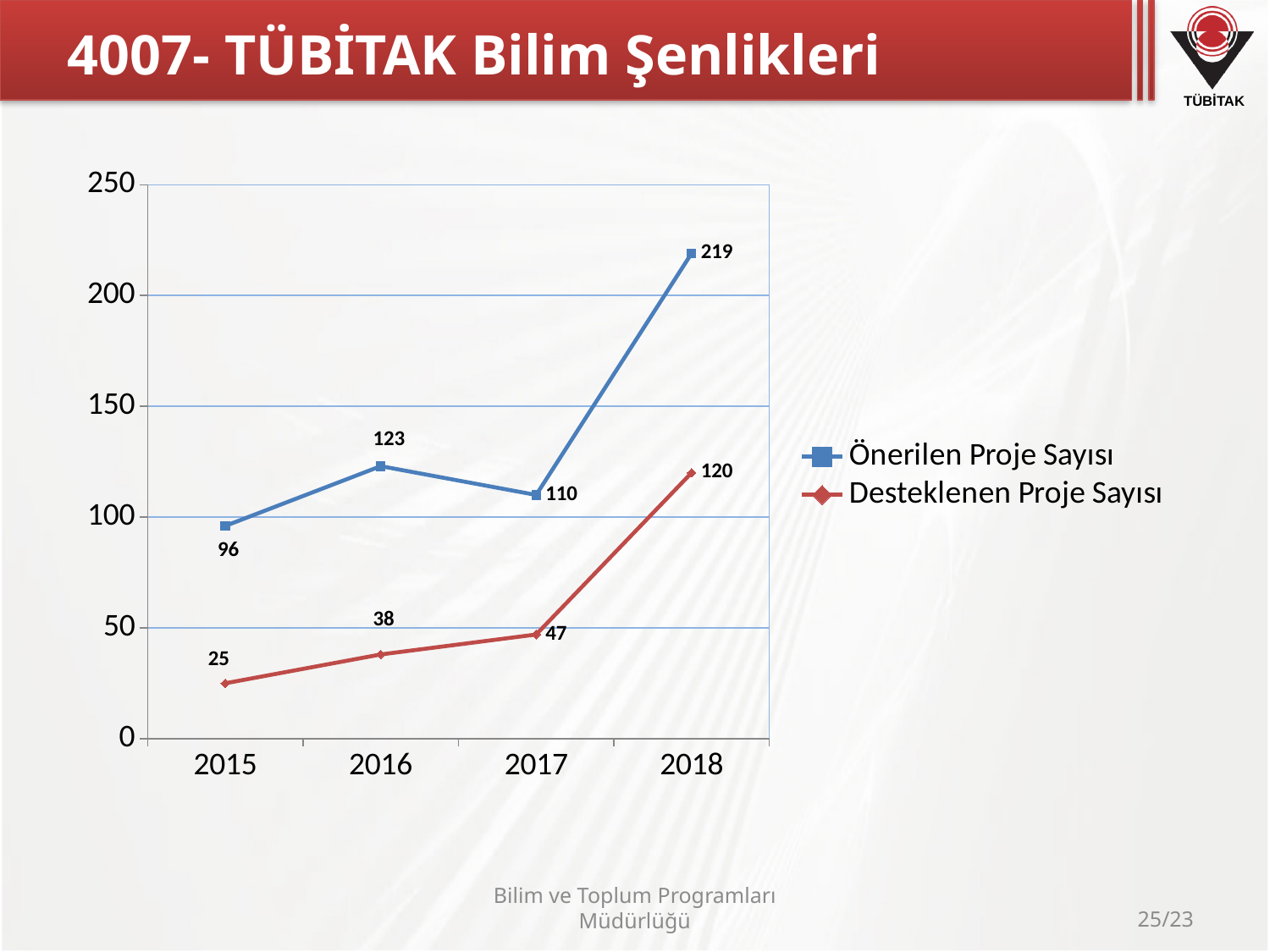
What is the value of Önerilen Proje Sayısı in 2015? 96 Which is larger: Önerilen Proje Sayısı in 2016 or Önerilen Proje Sayısı in 2017? Önerilen Proje Sayısı in 2016 How many series does the legend list? 2 What is the value of Desteklenen Proje Sayısı in 2016? 38 How many years are shown on the x axis? 4 What is the difference between Önerilen Proje Sayısı and Desteklenen Proje Sayısı in 2017? 63 In which year is Desteklenen Proje Sayısı highest? 2018 What is the value of Önerilen Proje Sayısı in 2018? 219 In which year is Önerilen Proje Sayısı lowest? 2015 Does Desteklenen Proje Sayısı rise or fall from 2015 to 2018? rise What kind of chart is shown on the slide? line chart Is the value of Desteklenen Proje Sayısı in 2018 greater or less than 100? greater